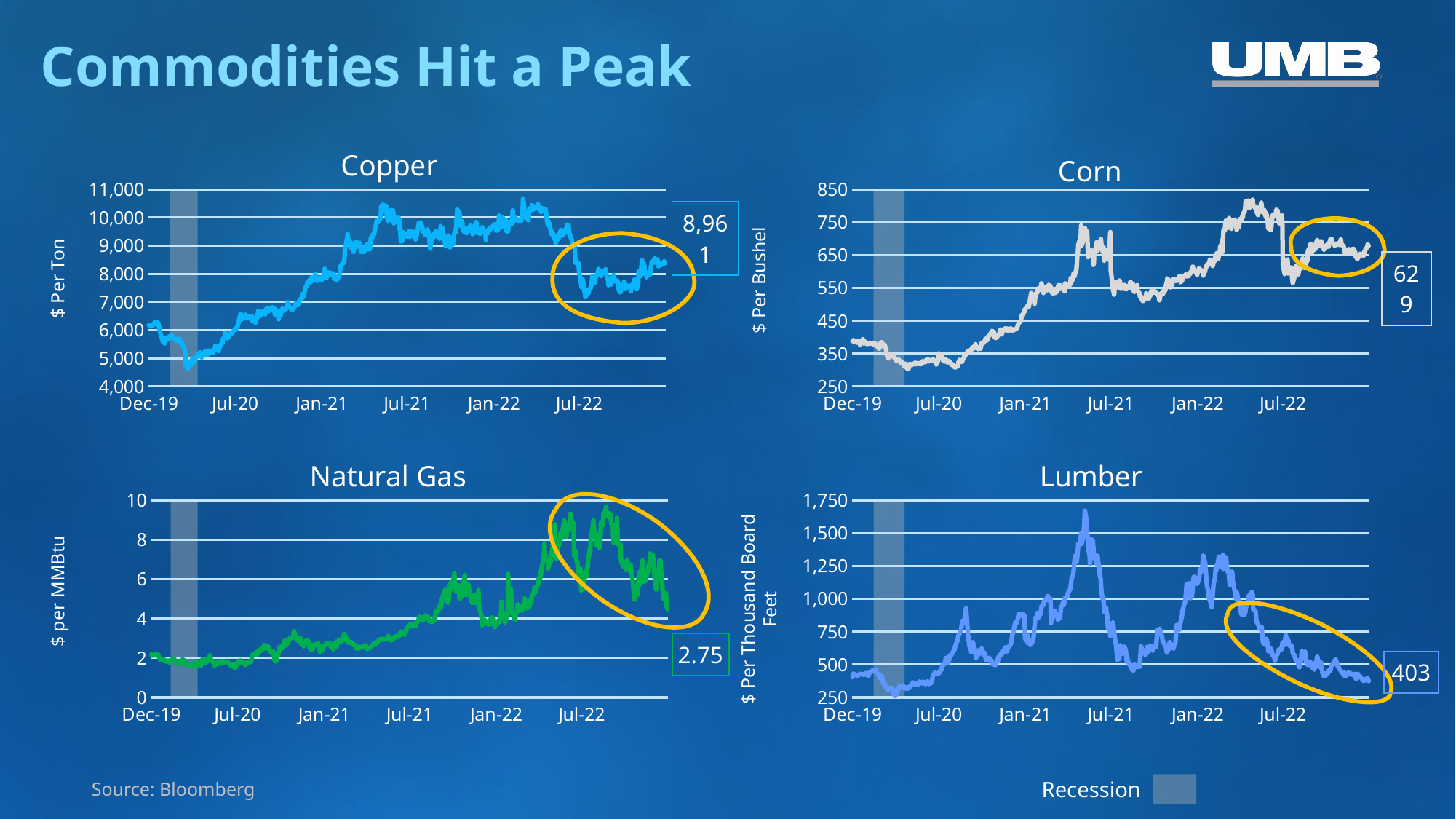
On the Corn chart, what is the latest value labelled at the end of the line? 629 How many charts are shown on the slide? 4 On the Copper chart, is the value at Dec-19 greater or less than 5,000? greater What kind of chart is the Copper chart? line chart On the Natural Gas chart, what is the latest value labelled at the end of the line? 2.75 On the Lumber chart, is the peak value reached around mid-2021 greater or less than 1,500? greater On the Natural Gas chart, is the peak value reached in 2022 greater or less than 8? greater On the Lumber chart, what is the latest value labelled at the end of the line? 403 What does the grey shaded area on the charts represent, according to the legend? Recession On the Lumber chart, does the line rise or fall between Jan-22 and the end of the series? fall On the Copper chart, what is the y-axis unit label? $ Per Ton On the Copper chart, what is the latest value labelled at the end of the line? 8,961